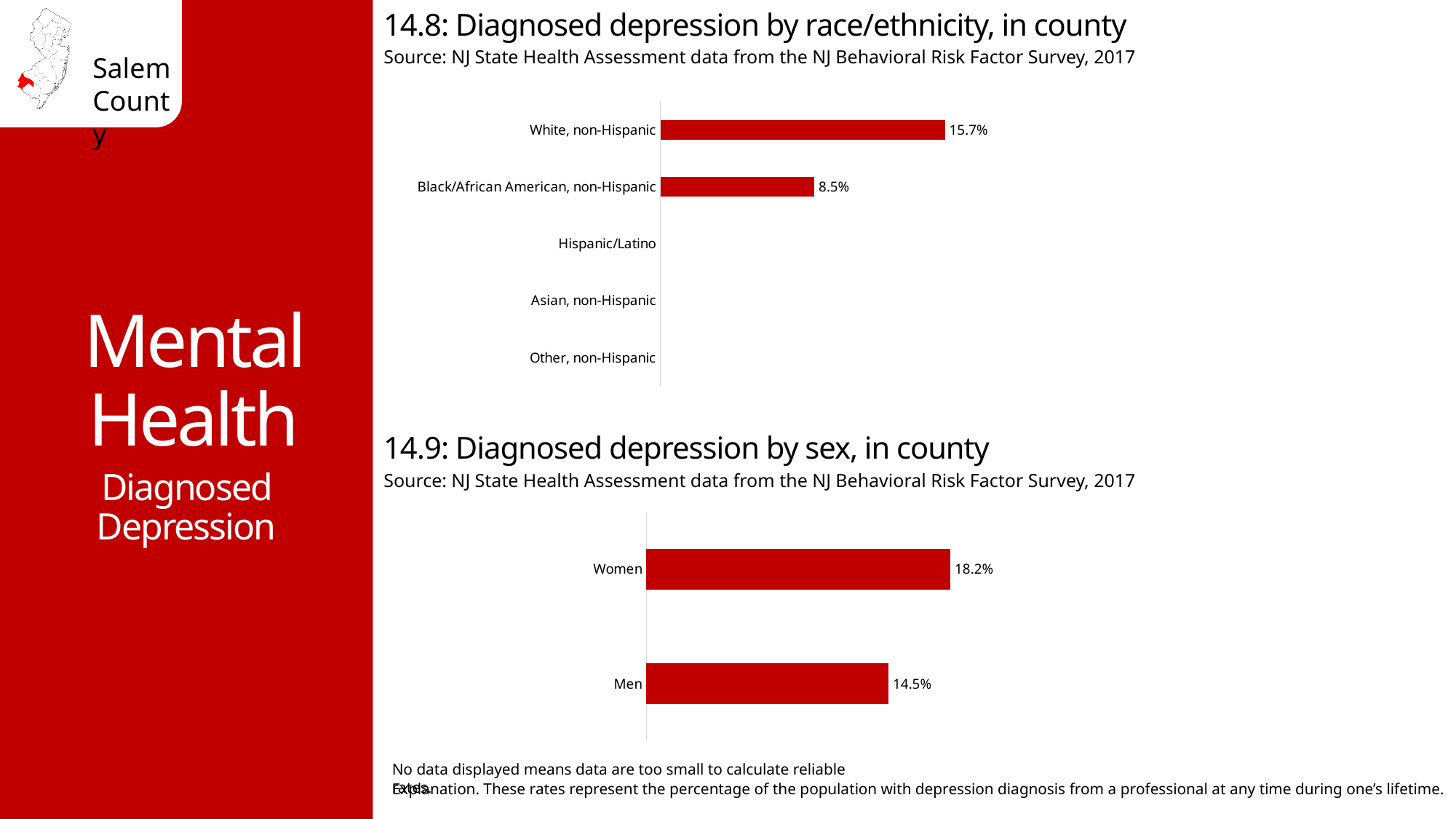
In the chart '14.9: Diagnosed depression by sex, in county', what is the difference between the Women and Men values? 3.7% In the chart '14.9: Diagnosed depression by sex, in county', what is the value for Men? 14.5% In the chart '14.9: Diagnosed depression by sex, in county', what is the value for Women? 18.2% What kind of chart is '14.9: Diagnosed depression by sex, in county'? Bar chart In the chart '14.8: Diagnosed depression by race/ethnicity, in county', what is the value for Black/African American, non-Hispanic? 8.5% In the chart '14.9: Diagnosed depression by sex, in county', how many categories are shown? 2 In the chart '14.8: Diagnosed depression by race/ethnicity, in county', which category has the highest value? White, non-Hispanic In the chart '14.8: Diagnosed depression by race/ethnicity, in county', what is the difference between the White, non-Hispanic and Black/African American, non-Hispanic values? 7.2% In the chart '14.8: Diagnosed depression by race/ethnicity, in county', which categories have no bar displayed? Hispanic/Latino, Asian, non-Hispanic, Other, non-Hispanic In the chart '14.9: Diagnosed depression by sex, in county', which category has the lower value? Men In the chart '14.8: Diagnosed depression by race/ethnicity, in county', what is the value for White, non-Hispanic? 15.7% In the chart '14.8: Diagnosed depression by race/ethnicity, in county', how many categories are listed on the axis? 5